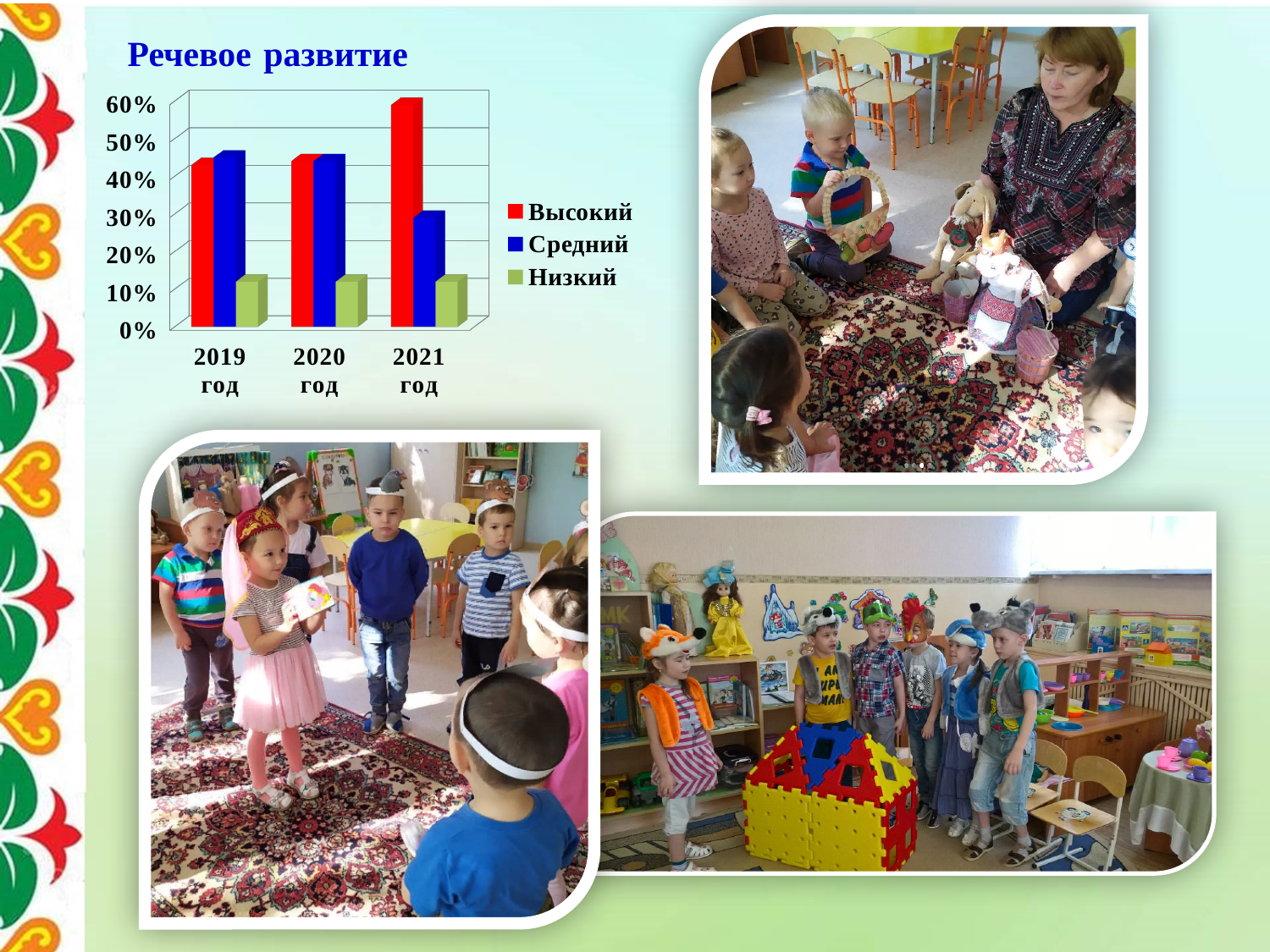
What kind of chart is shown on the slide? bar chart How many year categories are shown on the x axis of the chart? 3 In which year is the value for Высокий the highest? 2021 год What is the title of the chart? Речевое развитие Is the value for Низкий in 2019 год greater or less than 20%? less Which colour represents the series Низкий in the chart? green Is the value for Высокий in 2021 год greater or less than 50%? greater Is the value for Средний in 2021 год greater or less than 40%? less Does the value for Средний rise or fall from 2019 год to 2021 год? fall Does the value for Высокий rise or fall from 2019 год to 2021 год? rise How many series does the chart legend list? 3 In 2021 год, which is larger: Высокий or Средний? Высокий